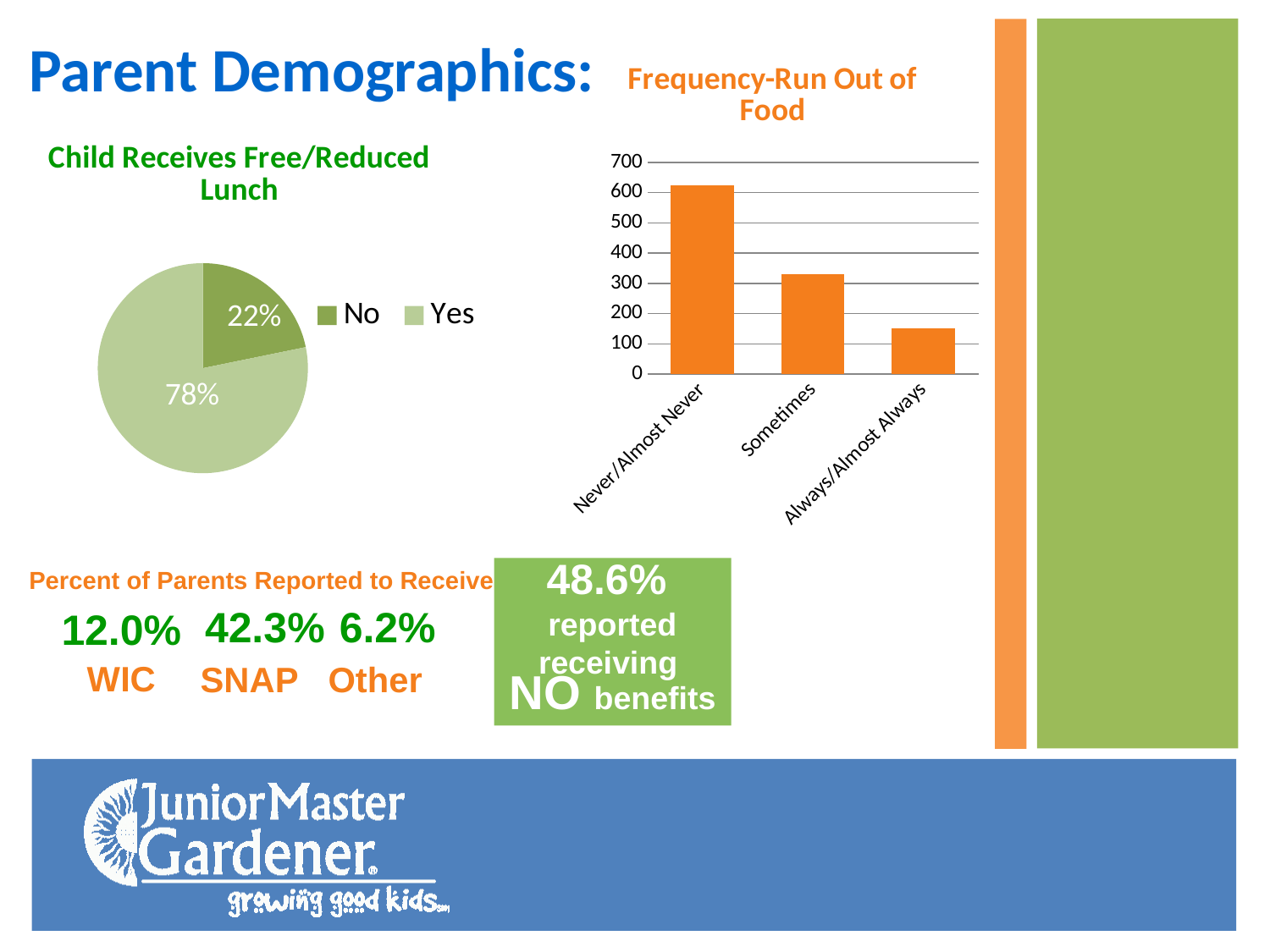
In the 'Frequency-Run Out of Food' chart, is the value for 'Never/Almost Never' greater or less than 600? greater In the 'Child Receives Free/Reduced Lunch' chart, what percentage of children receive free/reduced lunch (Yes)? 78% In the 'Child Receives Free/Reduced Lunch' chart, what is the value for 'No'? 22% In the 'Frequency-Run Out of Food' chart, do the values rise or fall from left to right along the x axis? Fall In the 'Frequency-Run Out of Food' chart, which category has the lowest value? Always/Almost Always In the 'Child Receives Free/Reduced Lunch' chart, which slice is larger, 'No' or 'Yes'? Yes How many entries does the legend of the 'Child Receives Free/Reduced Lunch' chart list? 2 How many categories are shown in the 'Frequency-Run Out of Food' chart? 3 In the 'Frequency-Run Out of Food' chart, which category has the highest value? Never/Almost Never What kind of chart is the 'Frequency-Run Out of Food' chart? Bar chart In the 'Child Receives Free/Reduced Lunch' chart, what is the difference between the 'Yes' and 'No' percentages? 56% What kind of chart is the 'Child Receives Free/Reduced Lunch' chart? Pie chart